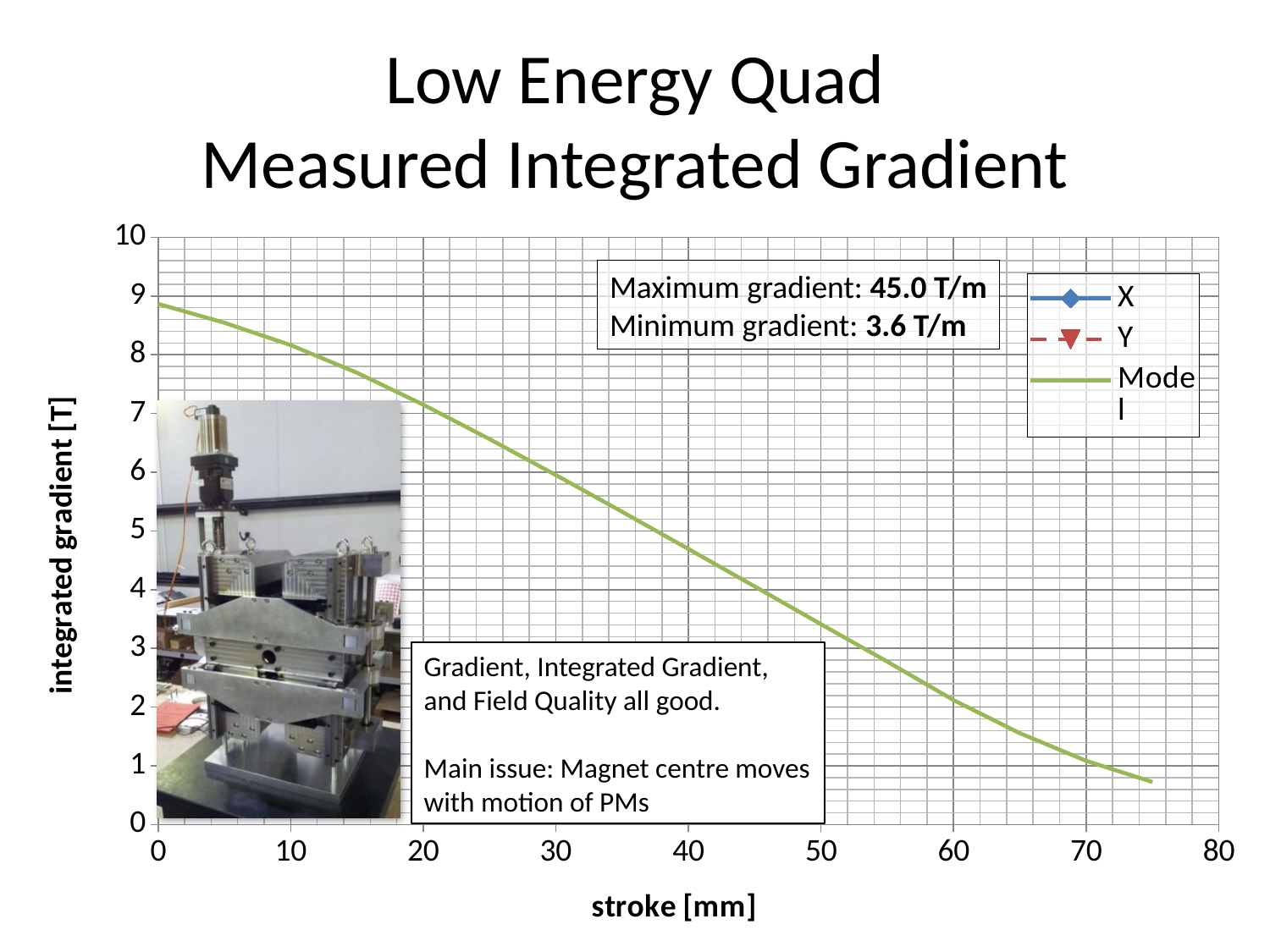
Which is larger for the Model series: the value at a stroke of 10 mm or at 60 mm? 10 mm What kind of chart is shown on the slide? line chart Is the Model value at a stroke of 50 mm greater or less than 3? greater Does the Model series rise or fall as stroke increases from 0 to 75 mm? fall What is the label of the chart's y axis? integrated gradient [T] Is the Model value at a stroke of 50 mm greater or less than 4? less Is the Model value at a stroke of 0 mm greater or less than 8? greater How many series does the chart legend list? 3 At which stroke value does the Model series reach its highest integrated gradient? 0 What is the label of the chart's x axis? stroke [mm]